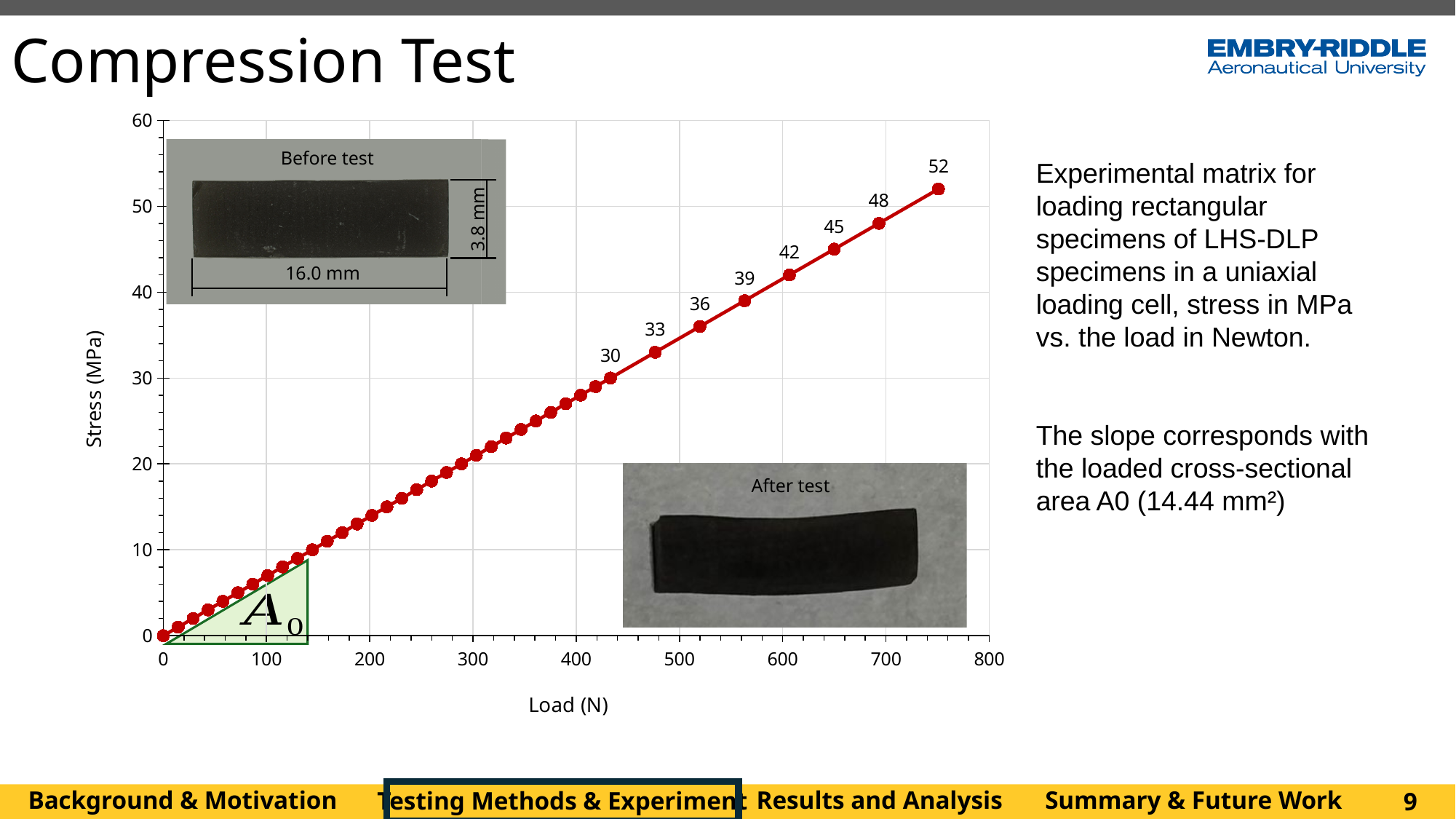
What is the title of the x axis of the chart? Load (N) How many data points on the chart have printed data labels? 8 Does the stress rise or fall as the load increases along the x axis? rises Is the stress at a load of 200 N greater or less than 20 MPa? less What is the title of the y axis of the chart? Stress (MPa) Is the stress at a load of 600 N greater or less than 40 MPa? greater What is the lowest stress value printed as a data label on the chart? 30 What is the highest stress value labeled on the chart? 52 What is the difference between the two highest labeled stress values, 52 and 48? 4 Which is larger: the stress labeled at the last data point or the stress labeled at the point just before it? the last data point (52) What type of chart is shown on the slide? line chart What is the difference between the labeled stress values 45 and 30? 15